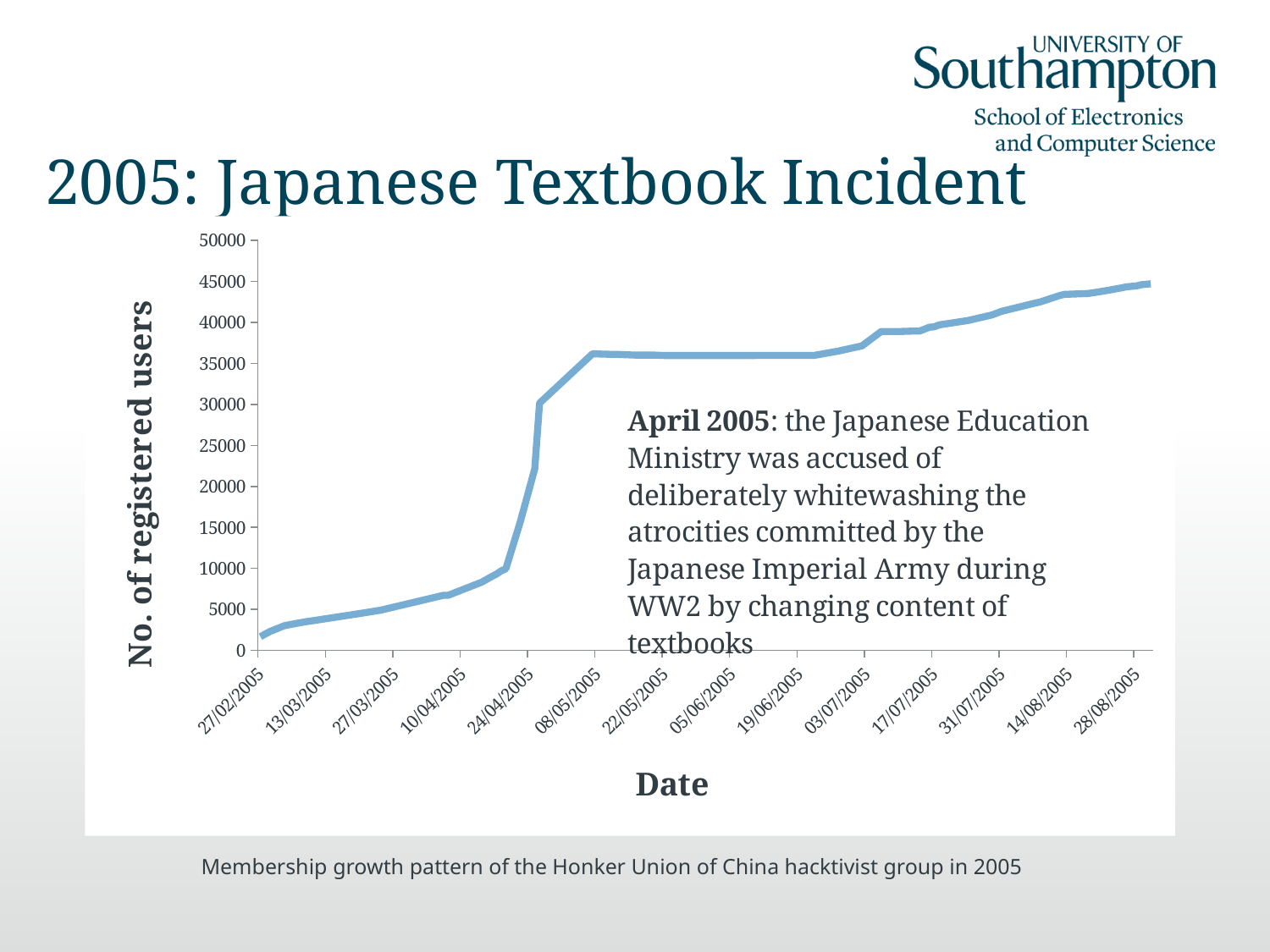
Do the values rise or fall along the x axis from 27/02/2005 to 28/08/2005? rise How many date labels are shown on the x axis? 14 Is the value for 08/05/2005 greater or less than 30000? greater Is the value for 27/02/2005 greater or less than 5000? less Which date on the x axis has the lowest number of registered users? 27/02/2005 Which date on the x axis has the highest number of registered users? 28/08/2005 Which date has the higher number of registered users, 27/02/2005 or 28/08/2005? 28/08/2005 Is the value for 10/04/2005 greater or less than 10000? less What is the title of the y axis? No. of registered users What kind of chart is shown on the slide? line chart